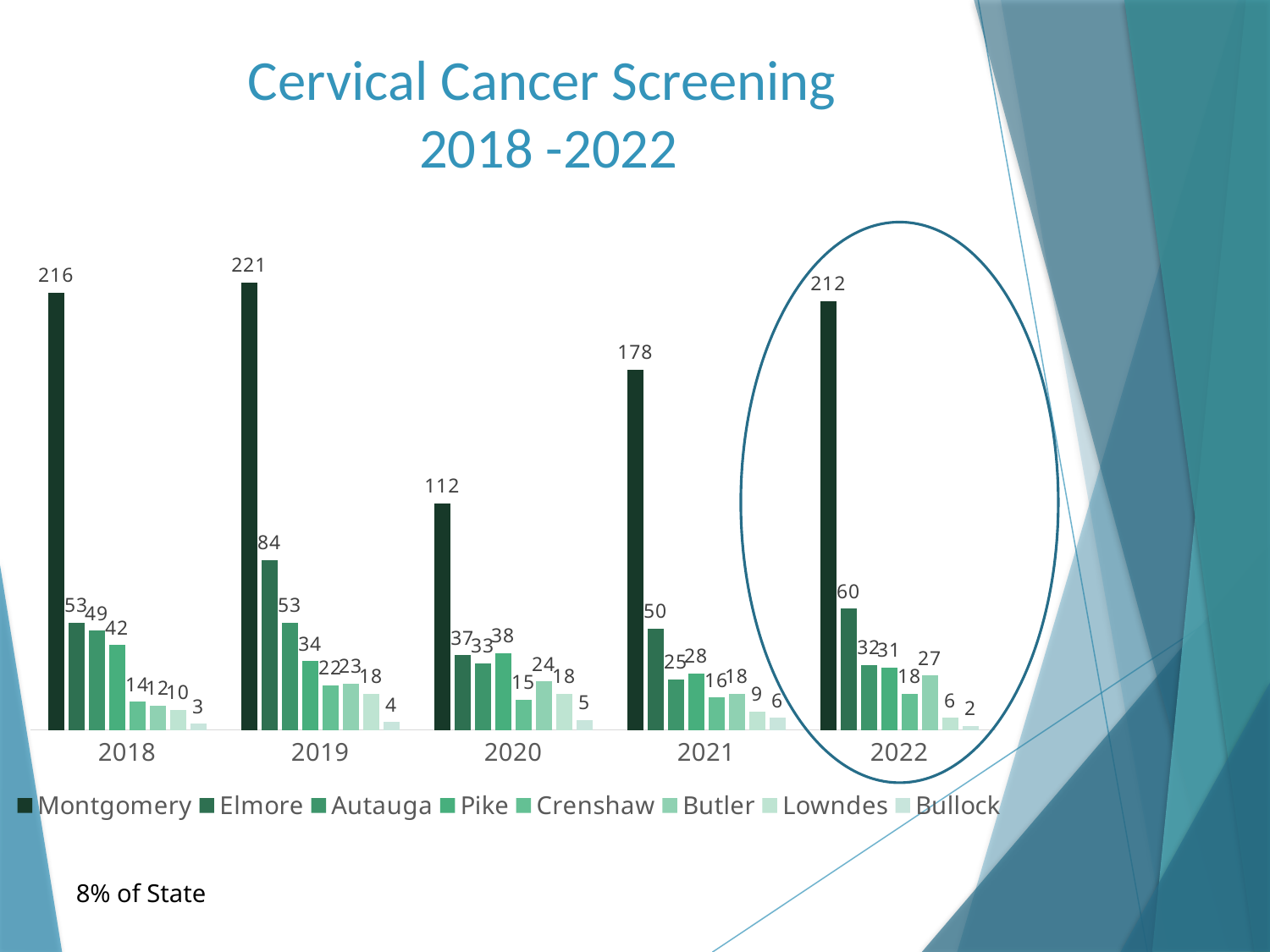
What is the value for Montgomery in 2020? 112 What is the value for Bullock in 2018? 3 What kind of chart is shown on the slide? Bar chart What is the value for Elmore in 2022? 60 In which year is the Montgomery value lowest? 2020 In which year is the Montgomery value highest? 2019 How many years are shown on the x axis? 5 What is the difference between the Montgomery values for 2019 and 2018? 5 How many series does the legend list? 8 Which year's group of bars is circled on the slide? 2022 Which is larger, the Elmore value in 2019 or in 2021? 2019 What is the value for Montgomery in 2019? 221